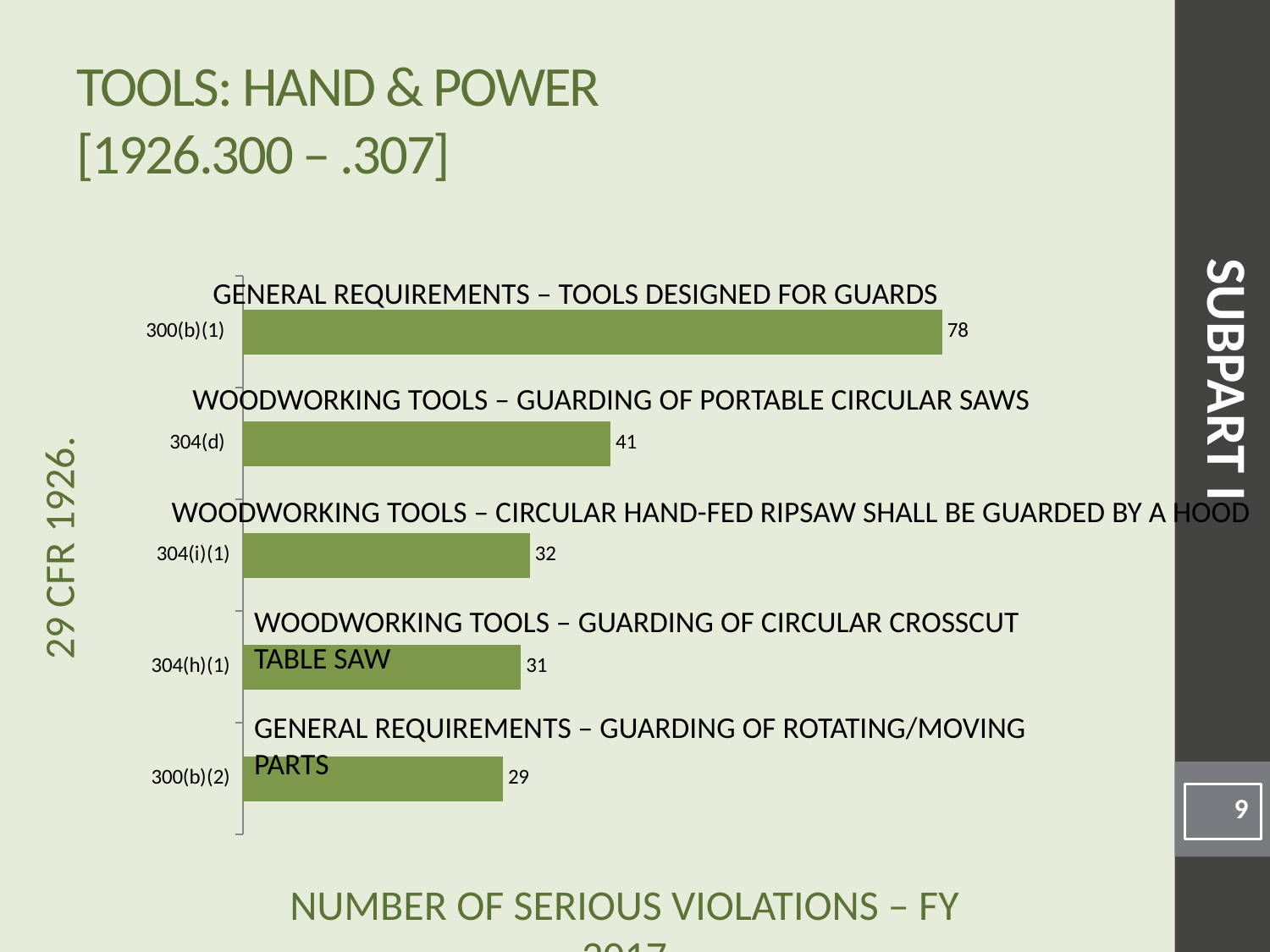
Which standard has the lowest number of serious violations? 300(b)(2) How many standards (bars) are shown in the chart? 5 What is the difference between the violations for 300(b)(1) and 304(d)? 37 What is the number of serious violations for 300(b)(2)? 29 What is the difference between the violations for 304(h)(1) and 300(b)(2)? 2 What is the number of serious violations for 304(i)(1)? 32 What is the number of serious violations for 304(d)? 41 Which standard has the highest number of serious violations? 300(b)(1) What is the description shown for the 304(d) bar? WOODWORKING TOOLS – GUARDING OF PORTABLE CIRCULAR SAWS Which has more serious violations, 304(d) or 304(i)(1)? 304(d) What kind of chart is shown on the slide? Bar chart What is the number of serious violations for 300(b)(1)? 78